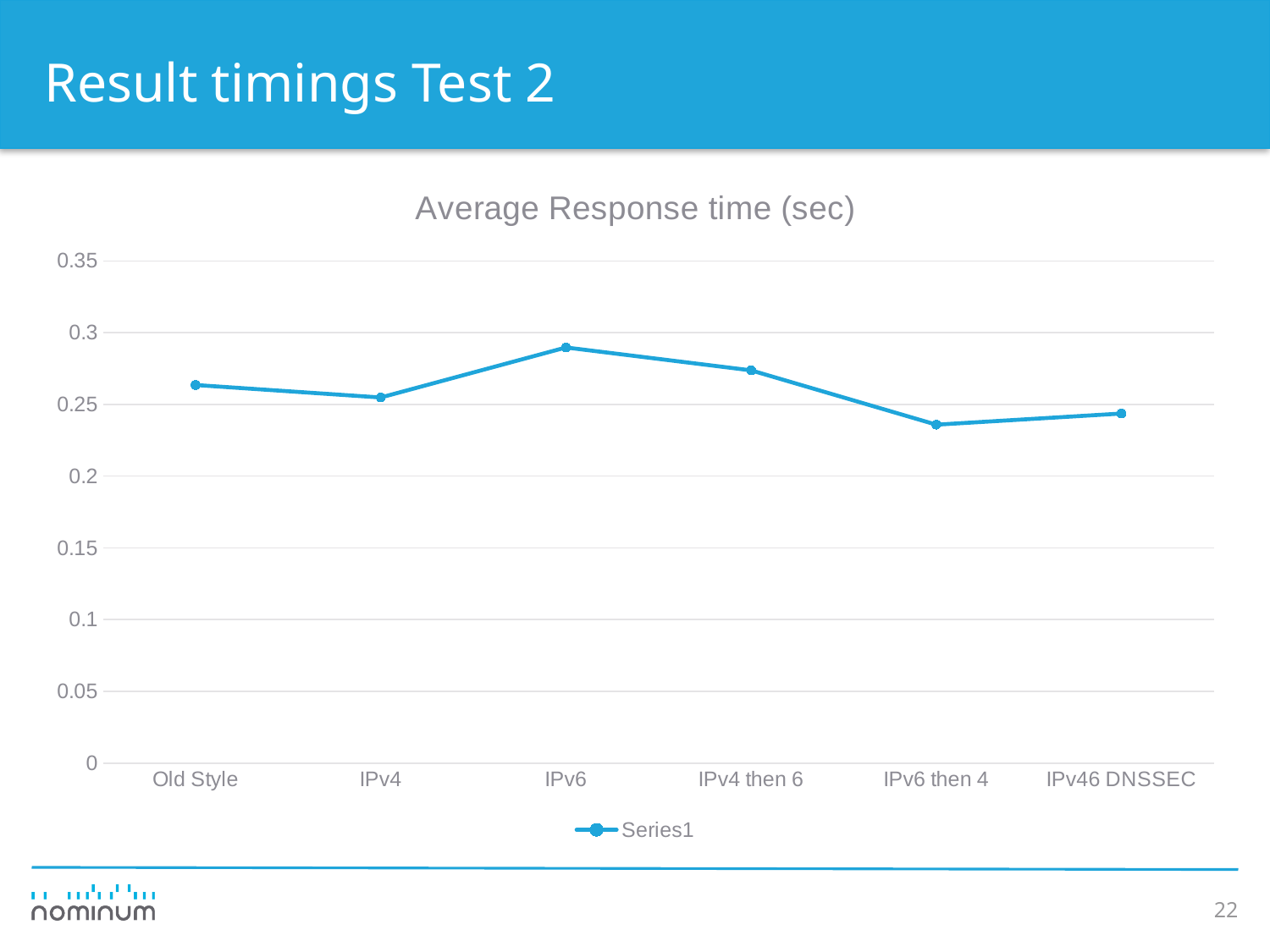
What kind of chart is shown on the slide? line chart Which category has the highest average response time? IPv6 What is the name of the series shown in the legend? Series1 Is the value for IPv4 then 6 greater or less than 0.3? less Which category has the lowest average response time? IPv6 then 4 Which has a larger value, IPv6 or IPv4 then 6? IPv6 How many series does the legend list? 1 Is the value for IPv6 then 4 greater or less than 0.25? less What is the title of the chart? Average Response time (sec) How many categories are plotted along the x axis? 6 Is the value for IPv6 greater or less than 0.25? greater Which has a larger value, Old Style or IPv46 DNSSEC? Old Style